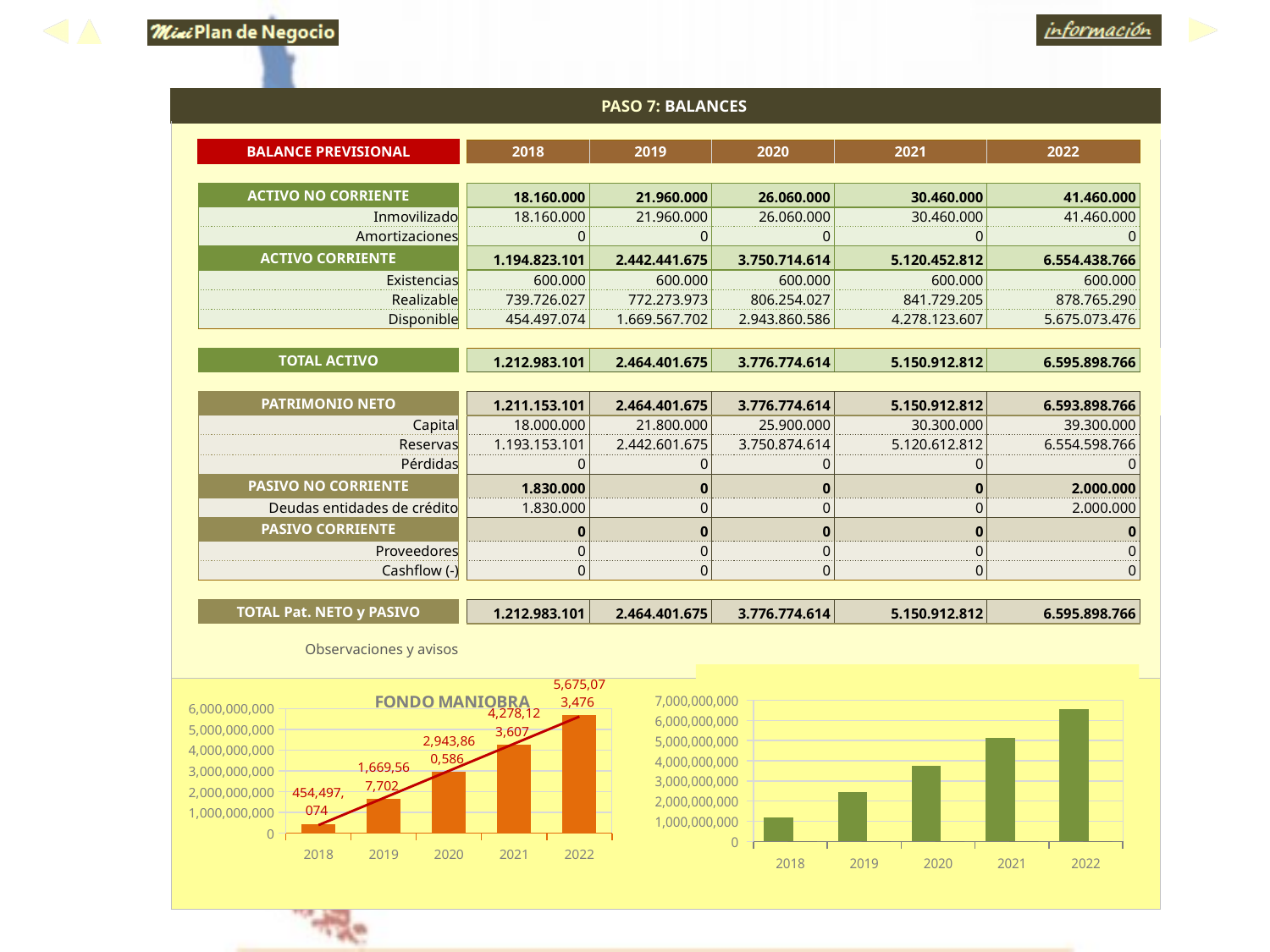
In the green bar chart on the right of the slide, which year has the tallest bar? 2022 In the FONDO MANIOBRA chart, which year has the larger value, 2019 or 2020? 2020 In the green bar chart on the right of the slide, is the value for 2020 greater or less than 4,000,000,000? less In the green bar chart on the right of the slide, is the value for 2018 greater or less than 1,000,000,000? greater In the FONDO MANIOBRA chart, what kind of chart is used to show the values? bar chart What is the title of the chart on the left of the slide? FONDO MANIOBRA In the FONDO MANIOBRA chart, do the values rise or fall from 2018 to 2022? rise In the FONDO MANIOBRA chart, how many years are plotted on the x axis? 5 In the FONDO MANIOBRA chart, what is the value labelled for 2022? 5,675,073,476 In the FONDO MANIOBRA chart, what is the value labelled for 2018? 454,497,074 In the FONDO MANIOBRA chart, which year has the highest value? 2022 In the FONDO MANIOBRA chart, which year has the lowest value? 2018